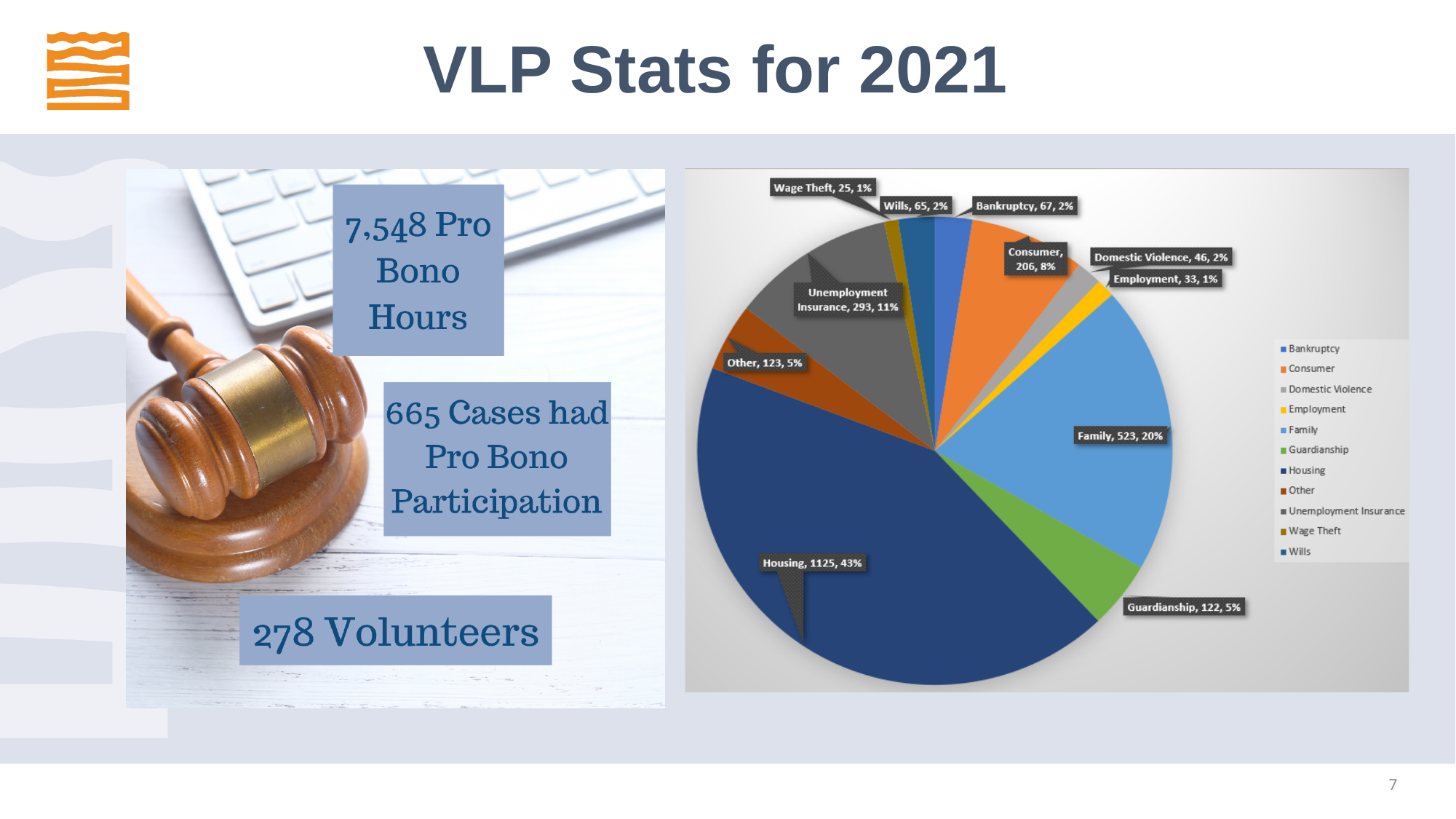
What type of chart is shown on the slide? pie chart Which category has the smallest slice of the pie chart? Wage Theft What is the difference between the values for Family and Guardianship? 401 Which category has the largest slice of the pie chart? Housing What is the value for Employment in the pie chart? 33 What is the value for Unemployment Insurance in the pie chart? 293 What share of the pie does Consumer represent? 8% What share of the pie does Family represent? 20% How many categories does the pie chart show? 11 What colour is the Housing slice in the pie chart? dark blue Which is larger, the value for Other or the value for Bankruptcy? Other What is the value for Housing in the pie chart? 1125